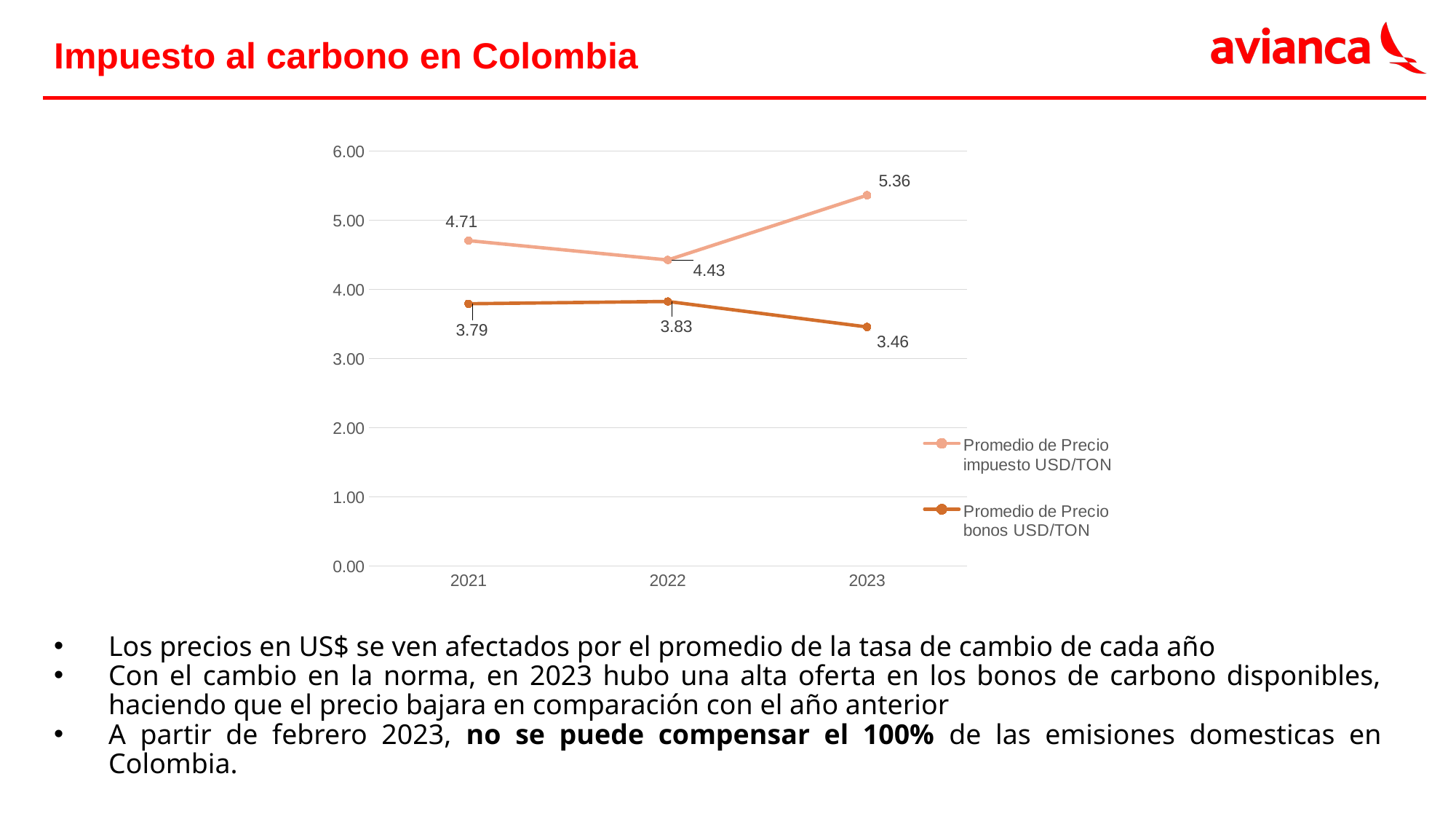
What is the difference between Promedio de Precio impuesto USD/TON and Promedio de Precio bonos USD/TON in 2023? 1.90 What kind of chart is shown on the slide? line chart How many years are shown on the x axis? 3 Which is larger in 2021: Promedio de Precio impuesto USD/TON or Promedio de Precio bonos USD/TON? Promedio de Precio impuesto USD/TON Does Promedio de Precio impuesto USD/TON rise or fall from 2022 to 2023? rise In which year is Promedio de Precio bonos USD/TON lowest? 2023 Is the value for Promedio de Precio bonos USD/TON in 2022 greater or less than 4.00? less In which year is Promedio de Precio impuesto USD/TON highest? 2023 What is the value of Promedio de Precio impuesto USD/TON in 2023? 5.36 What is the value of Promedio de Precio impuesto USD/TON in 2022? 4.43 What is the value of Promedio de Precio bonos USD/TON in 2021? 3.79 How many series does the legend list? 2